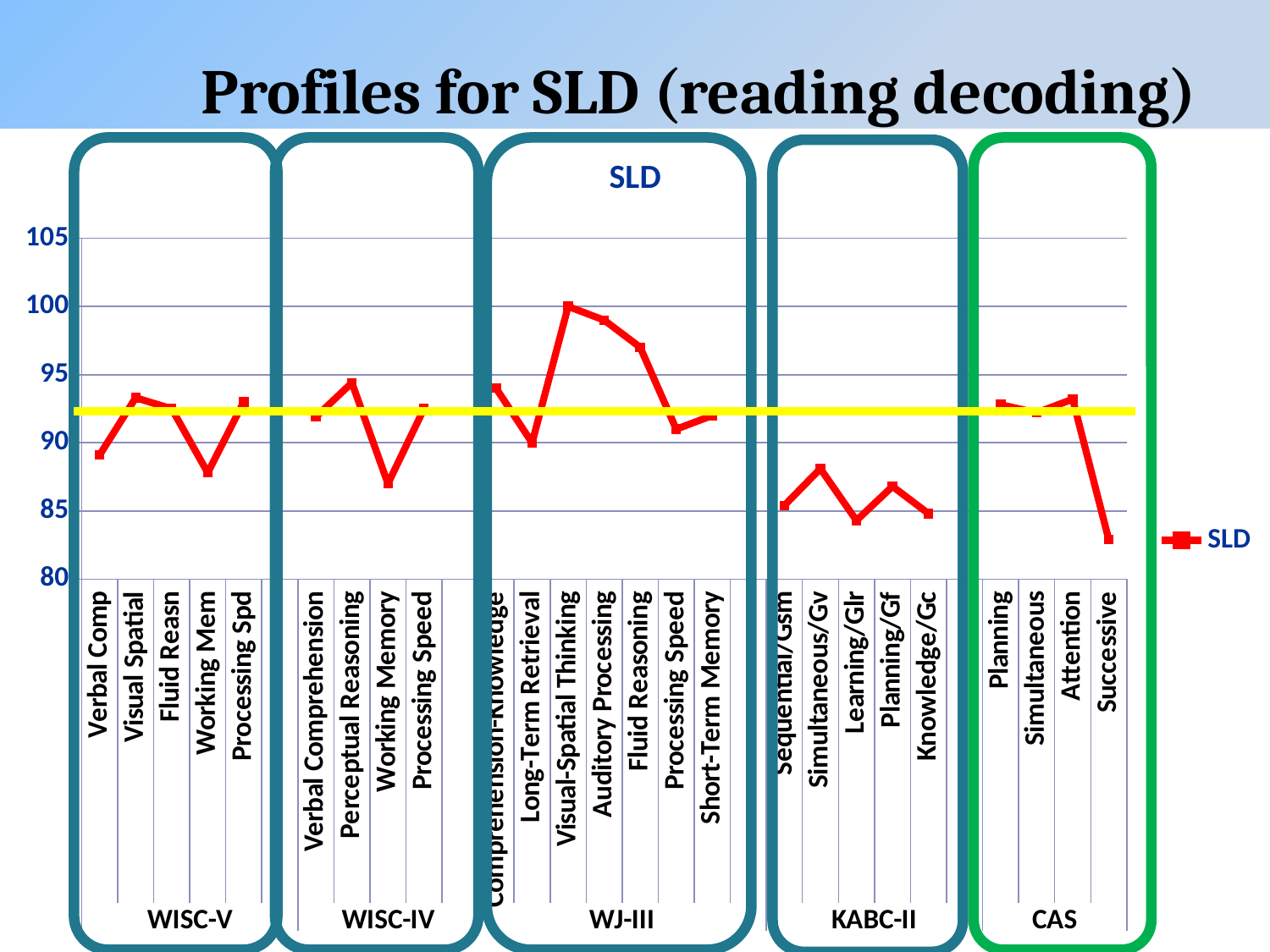
What kind of chart is shown on the slide? line chart Which is larger, the value for Perceptual Reasoning or the value for Working Memory in the WISC-IV group? Perceptual Reasoning Is the value for Auditory Processing greater or less than 95? greater Which category has the lowest value on the chart? Successive Is the value for Knowledge/Gc greater or less than 90? less What is the name of the series shown in the legend? SLD Is the value for Working Memory in the WISC-IV group greater or less than 90? less How many test groups (WISC-V, WISC-IV, etc.) are labelled along the bottom of the chart? 5 How many categories are plotted in the WJ-III group? 7 How many series does the legend list? 1 Which category has the highest value on the chart? Visual-Spatial Thinking Do the values rise or fall from Visual-Spatial Thinking to Processing Speed in the WJ-III group? fall